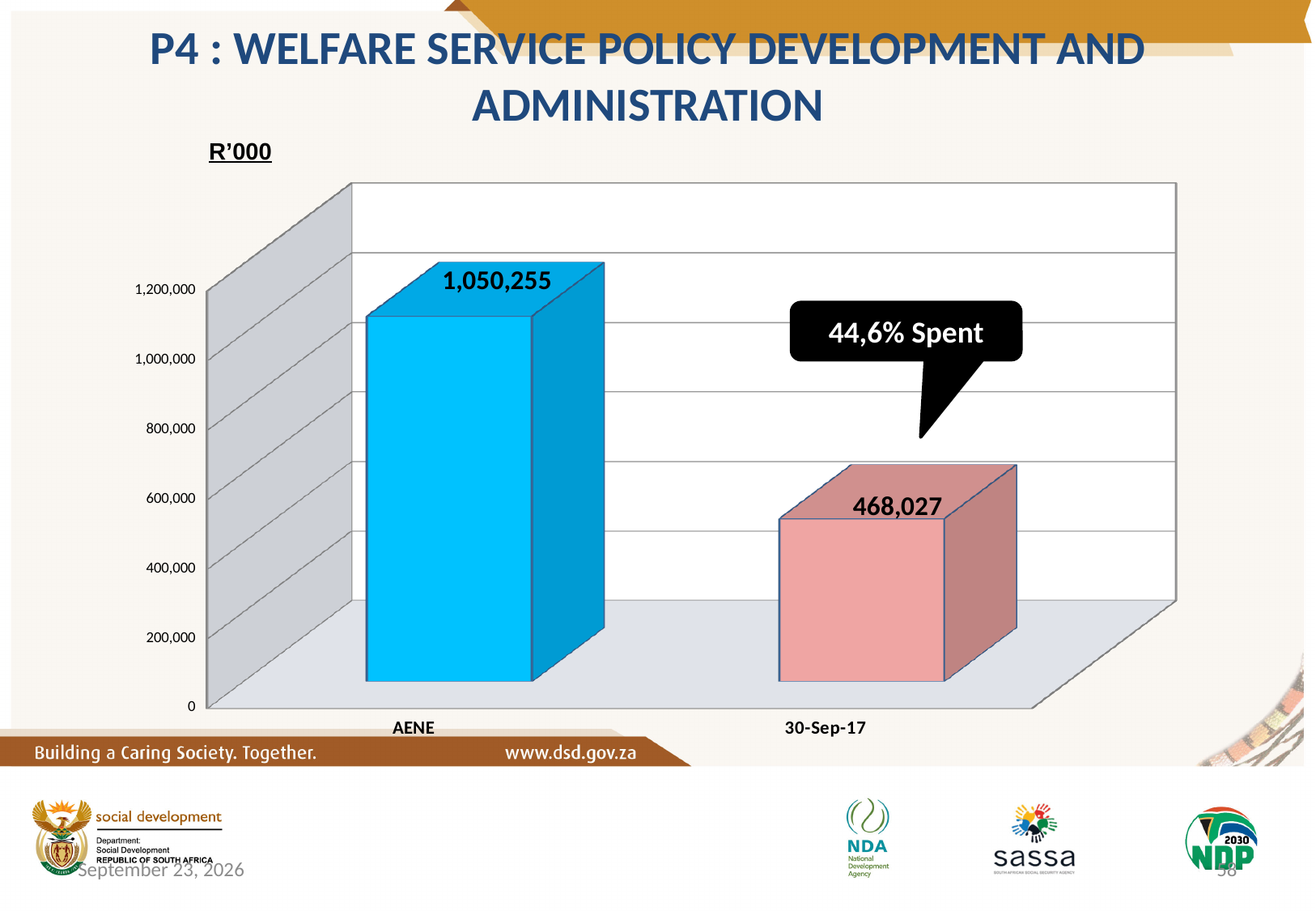
What kind of chart is shown on the slide? bar chart What percentage spent does the callout on the chart show? 44,6% Spent Which category has the lowest value? 30-Sep-17 What is the value for AENE? 1,050,255 What is the value for 30-Sep-17? 468,027 How many bars are plotted on the chart? 2 Which is larger, the value for AENE or the value for 30-Sep-17? AENE Is the value for 30-Sep-17 greater or less than 600,000? less Which category has the highest value? AENE What unit label is shown above the chart? R'000 Is the value for AENE greater or less than 1,000,000? greater What is the difference between the AENE value and the 30-Sep-17 value? 582,228